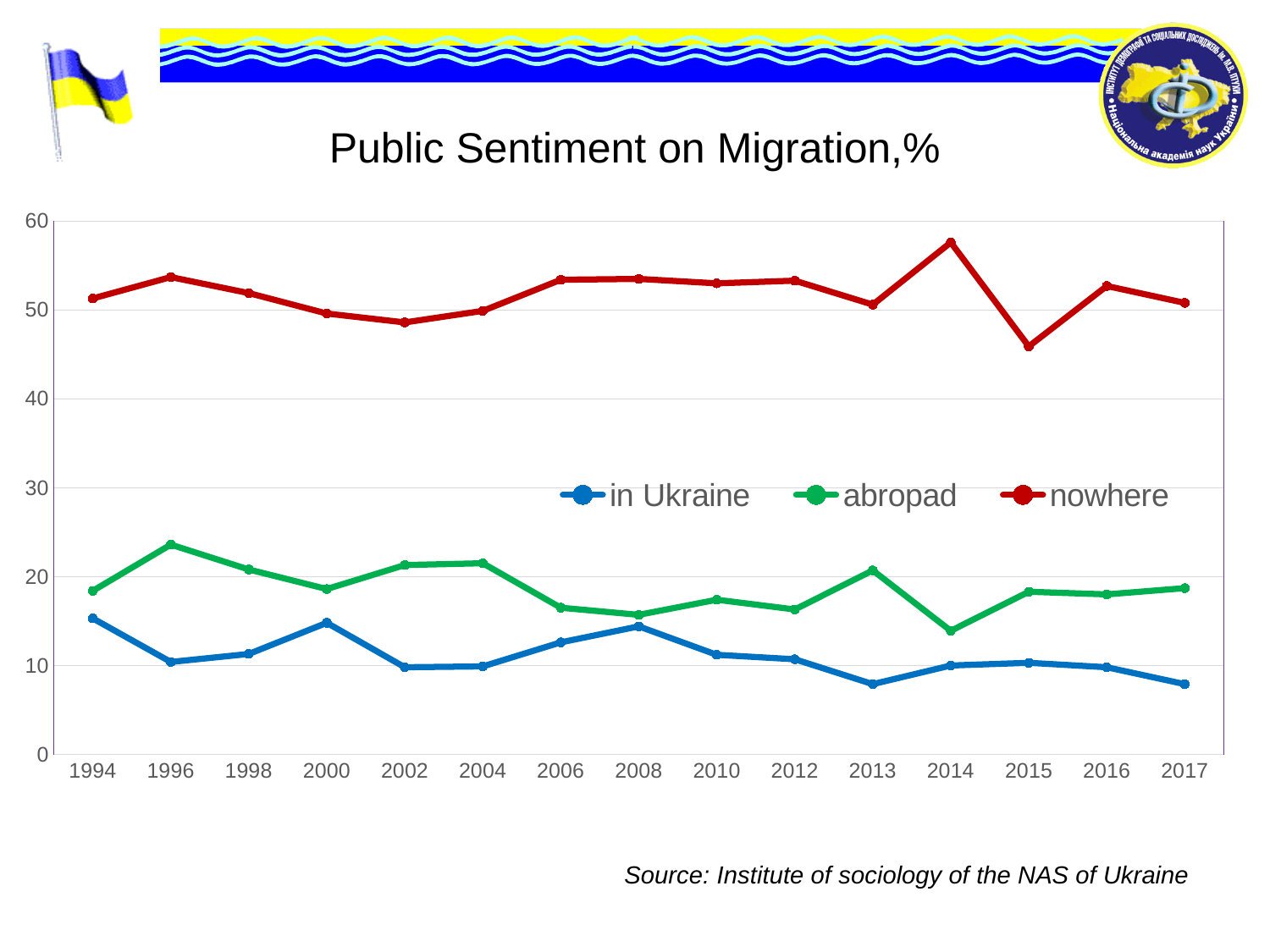
How many years are plotted along the x axis? 15 In which year does the 'nowhere' series reach its lowest value? 2015 What kind of chart is shown on the slide? line chart In which year does the 'nowhere' series reach its highest value? 2014 In which year does the 'abropad' series reach its highest value? 1996 What is the title of the chart? Public Sentiment on Migration,% Is the value for 'nowhere' in 2014 greater or less than 50? greater How many series does the legend list? 3 Is the value for 'abropad' in 1996 greater or less than 20? greater Is the value for 'nowhere' in 2015 greater or less than 50? less In 1996, which series has the larger value, 'abropad' or 'in Ukraine'? abropad